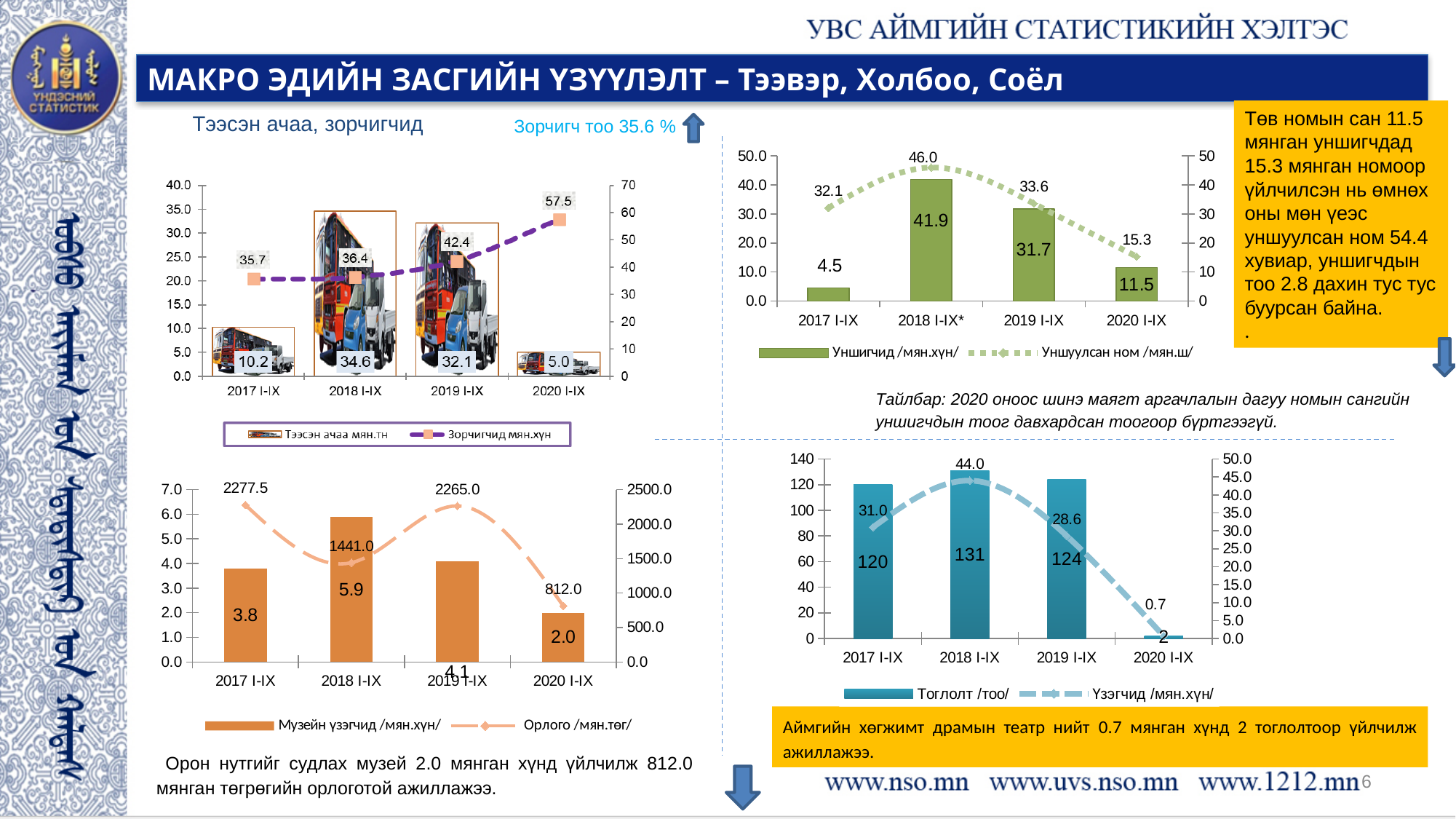
In the bottom-left chart (museum visitors and revenue), what is the Орлого (мян.төг) value for 2019 I-IX? 2265.0 In the top-right chart (library readers and books), what is the value of Уншигчид (мян.хүн) for 2018 I-IX*? 41.9 In the bottom-left chart (museum visitors and revenue), which is larger: Музейн үзэгчид in 2018 I-IX or in 2020 I-IX? 2018 I-IX In the top-left chart titled 'Тээсэн ачаа, зорчигчид', what is the value of Тээсэн ачаа (мян.тн) for 2018 I-IX? 34.6 In the bottom-right chart (theatre performances and audience), what is the Тоглолт (тоо) value for 2019 I-IX? 124 In the top-left chart titled 'Тээсэн ачаа, зорчигчид', what is the value of Зорчигчид (мян.хүн) for 2020 I-IX? 57.5 In the top-right chart (library readers and books), what is the difference between the Уншуулсан ном values for 2018 I-IX* and 2020 I-IX? 30.7 In the bottom-right chart (theatre performances and audience), how many series does the legend list? 2 How many periods (categories) are shown on the x axis of the bottom-right chart (theatre performances and audience)? 4 In the top-left chart titled 'Тээсэн ачаа, зорчигчид', does the Зорчигчид line rise or fall from 2017 I-IX to 2020 I-IX? rise In the top-right chart (library readers and books), which period has the highest Уншуулсан ном value? 2018 I-IX* In the top-left chart titled 'Тээсэн ачаа, зорчигчид', which period has the lowest Тээсэн ачаа value? 2020 I-IX